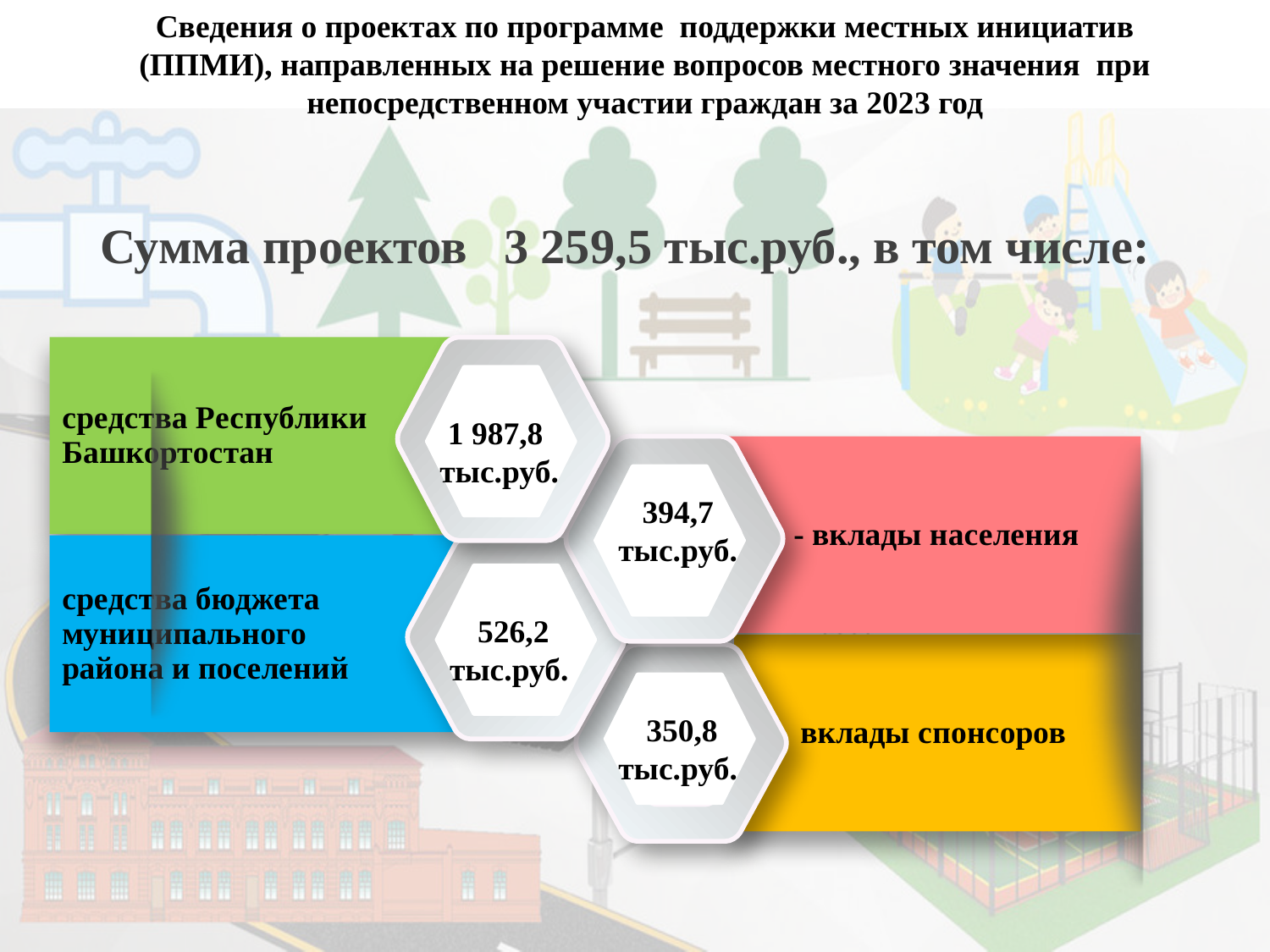
Which funding source has the highest value? средства Республики Башкортостан What is the value shown for «средства Республики Башкортостан»? 1 987,8 тыс.руб. What is the value shown for «вклады населения»? 394,7 тыс.руб. Which funding source has the lowest value? вклады спонсоров What colour is the block for «вклады спонсоров»? Yellow What is the difference between «средства Республики Башкортостан» and «средства бюджета муниципального района и поселений»? 1 461,6 тыс.руб. What is the total sum of the projects stated on the slide? 3 259,5 тыс.руб. How many funding sources are shown in the diagram? 4 Which is larger: «вклады населения» or «вклады спонсоров»? вклады населения What is the difference between «вклады населения» and «вклады спонсоров»? 43,9 тыс.руб. What is the value shown for «вклады спонсоров»? 350,8 тыс.руб. What is the value shown for «средства бюджета муниципального района и поселений»? 526,2 тыс.руб.